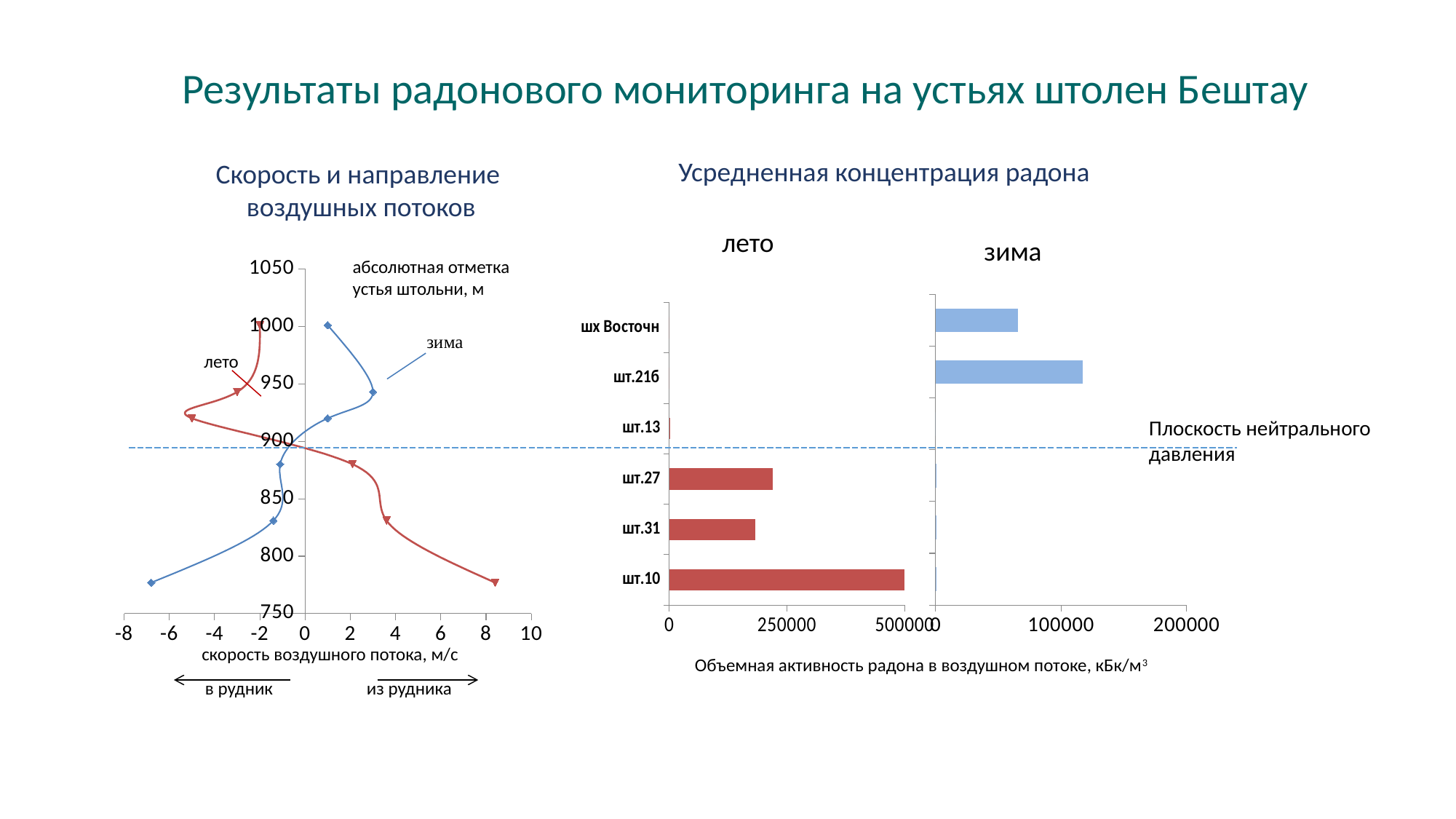
What kind of chart is the left chart titled "Скорость и направление воздушных потоков"? line chart In the "лето" bar chart, which category has the highest value? шт.10 In the "лето" bar chart, is the value for шт.10 greater or less than 250000? greater What kind of chart is the "лето" chart under "Усредненная концентрация радона"? bar chart In the "зима" bar chart, is the value for шх Восточн greater or less than 100000? less How many categories does the "лето" bar chart list on its vertical axis? 6 How many series does the left chart "Скорость и направление воздушных потоков" show? 2 In the "лето" bar chart, which is larger, the value for шт.27 or the value for шт.31? шт.27 In the left chart "Скорость и направление воздушных потоков", is the зима value at the lowest elevation (about 775 m) greater or less than -6? less In the "зима" bar chart, which category has the highest value? шт.216